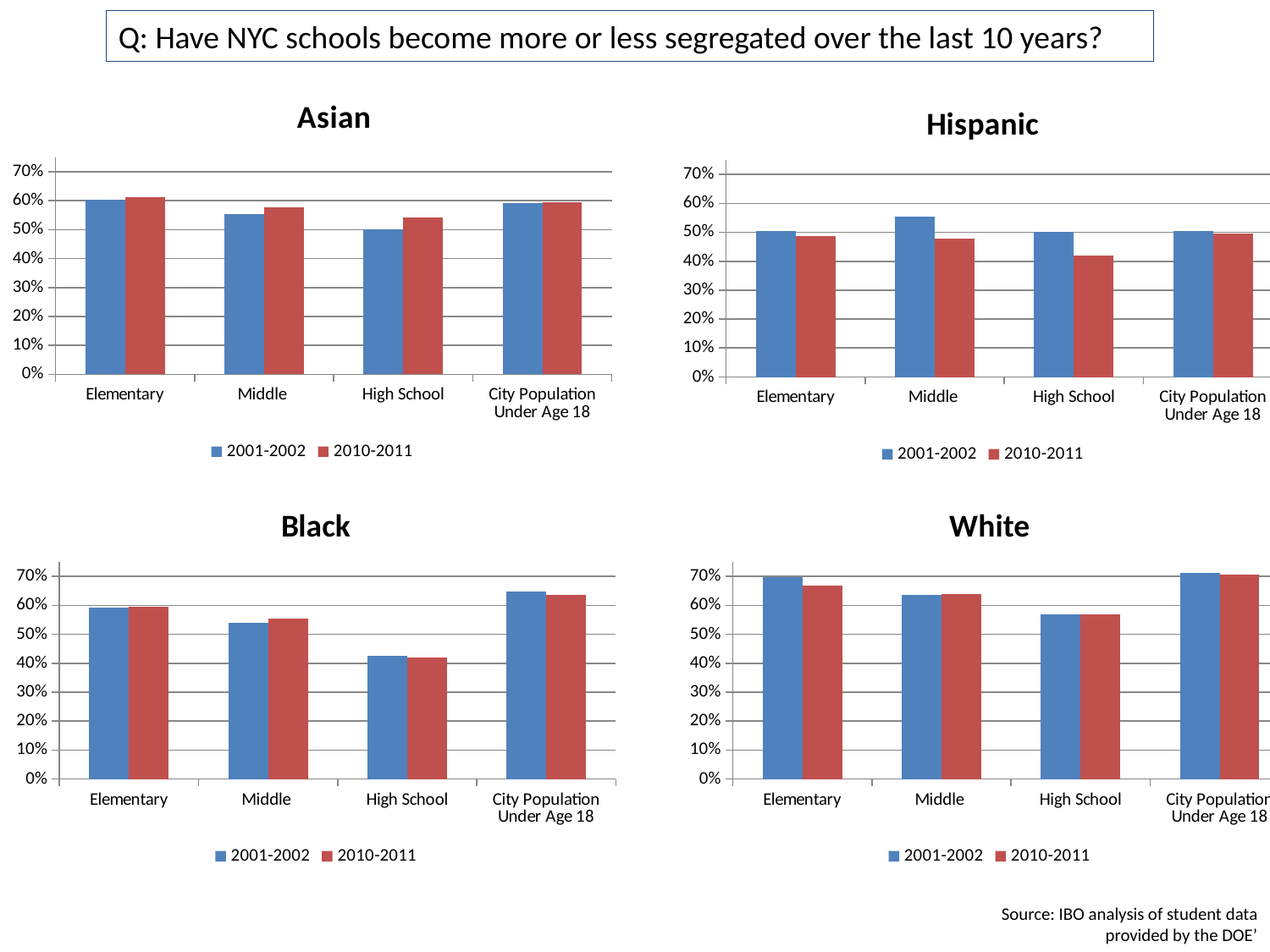
How many categories are shown on the x axis of the Black chart? 4 In the White chart, is the 2001-2002 value for High School greater or less than 60%? less In the Hispanic chart, is the 2001-2002 value for Middle greater or less than 50%? greater What are the two legend entries in the Hispanic chart? 2001-2002 and 2010-2011 In the Asian chart, for High School, which series has the larger value: 2001-2002 or 2010-2011? 2010-2011 In the Hispanic chart, is the 2010-2011 value for High School greater or less than 50%? less How many series does the legend of the Asian chart list? 2 In the Black chart, which category has the highest 2001-2002 value? City Population Under Age 18 In the Hispanic chart, which category has the lowest 2010-2011 value? High School What kind of chart is the Asian chart? bar chart In the White chart, for Elementary, which series has the larger value: 2001-2002 or 2010-2011? 2001-2002